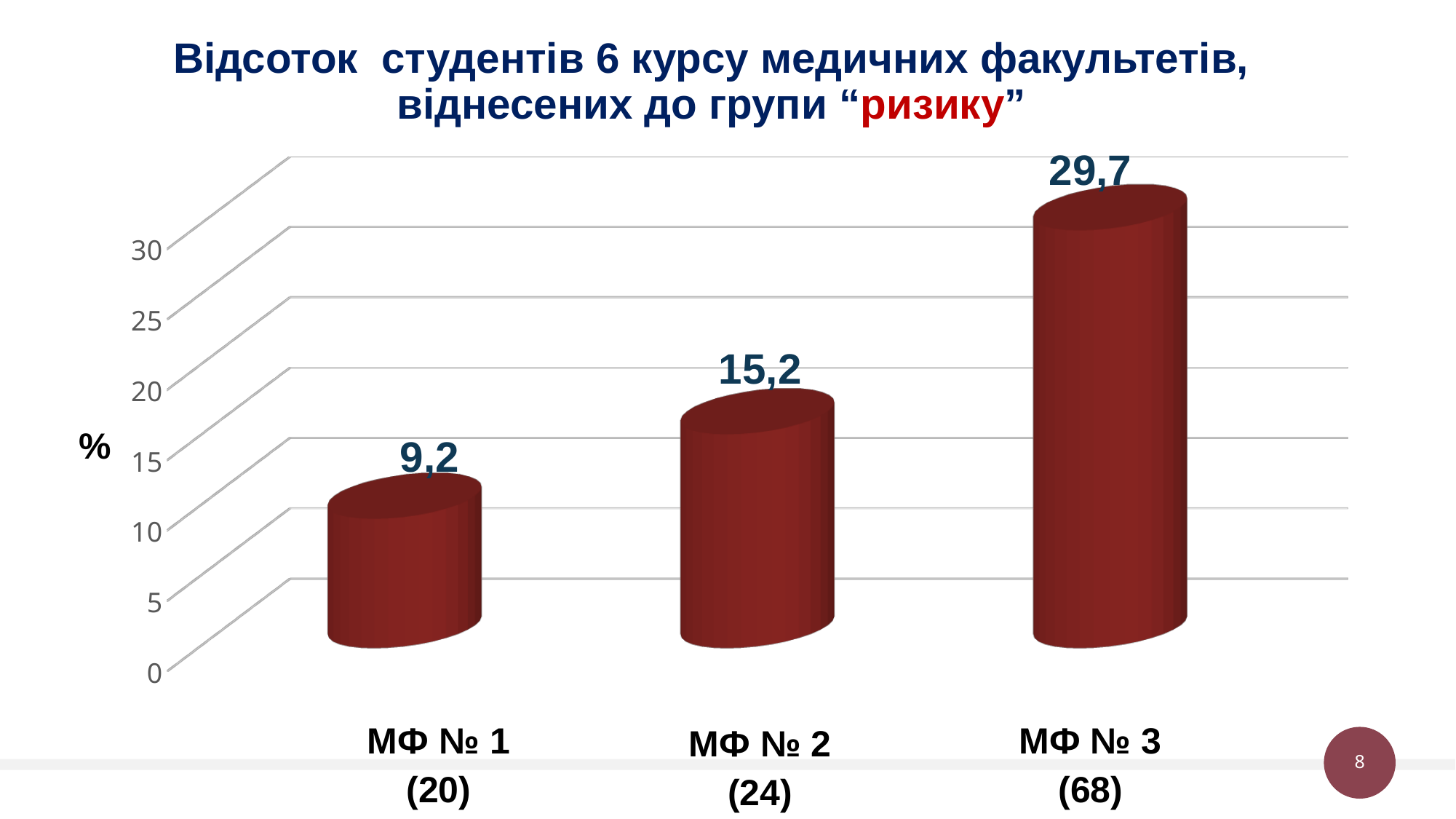
What kind of chart is shown on the slide? bar chart What is the value for МФ № 3? 29,7 Do the values rise or fall from МФ № 1 to МФ № 3? rise What is the difference between the values for МФ № 3 and МФ № 1? 20,5 Is the value for МФ № 3 greater or less than 25? greater What is the value for МФ № 1? 9,2 What is the value for МФ № 2? 15,2 What is the difference between the values for МФ № 2 and МФ № 1? 6 Which category has the lowest value? МФ № 1 Which category has the highest value? МФ № 3 How many categories are shown in the chart? 3 Which is larger, the value for МФ № 2 or the value for МФ № 1? МФ № 2